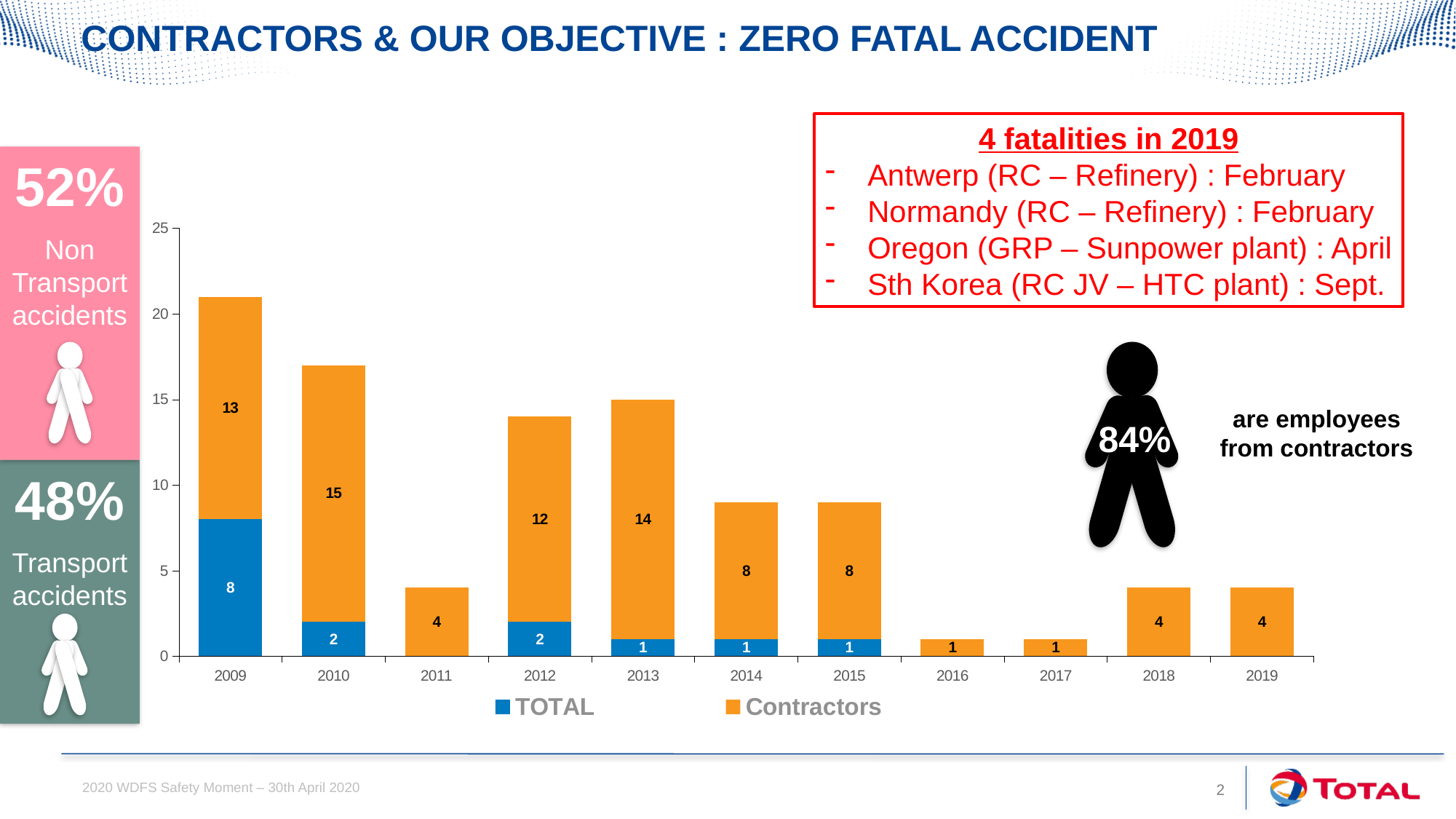
Is the Contractors value for 2012 larger than the Contractors value for 2015? Yes, 2012 Which year has the highest TOTAL value? 2009 What kind of chart is shown on the slide? Stacked bar chart What is the total of the stacked bar for 2009? 21 Which year has the highest Contractors value? 2010 What is the difference between the Contractors values for 2013 and 2014? 6 How many series does the legend list? 2 What is the TOTAL value for 2009? 8 How many years are shown on the x axis? 11 What is the total of the stacked bar for 2013? 15 What is the Contractors value for 2010? 15 What is the Contractors value for 2019? 4